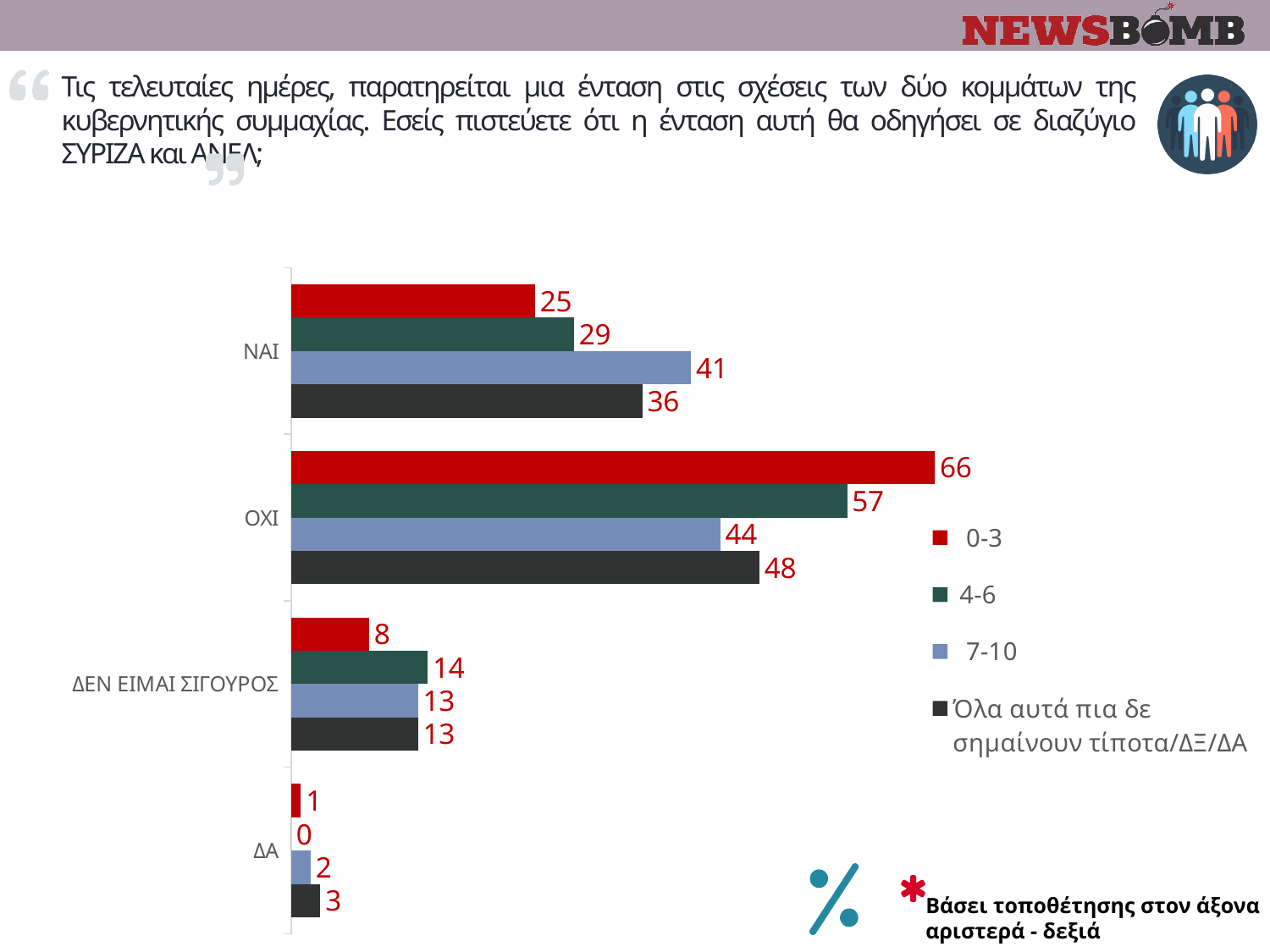
What type of chart is shown on the slide? bar chart Which series has the lowest value in the ΝΑΙ category? 0-3 What is the value for the 0-3 series in the ΟΧΙ category? 66 In the ΝΑΙ category, which is larger: the 7-10 value or the 4-6 value? 7-10 What is the value for the 4-6 series in the ΔΕΝ ΕΙΜΑΙ ΣΙΓΟΥΡΟΣ category? 14 What is the difference between the 0-3 and 4-6 values in the ΟΧΙ category? 9 How many series does the legend list? 4 Which series has the highest value in the ΟΧΙ category? 0-3 What is the value for the 7-10 series in the ΝΑΙ category? 41 What is the value for the 4-6 series in the ΔΑ category? 0 How many response categories are shown on the chart? 4 What colour are the bars for the 0-3 series? red